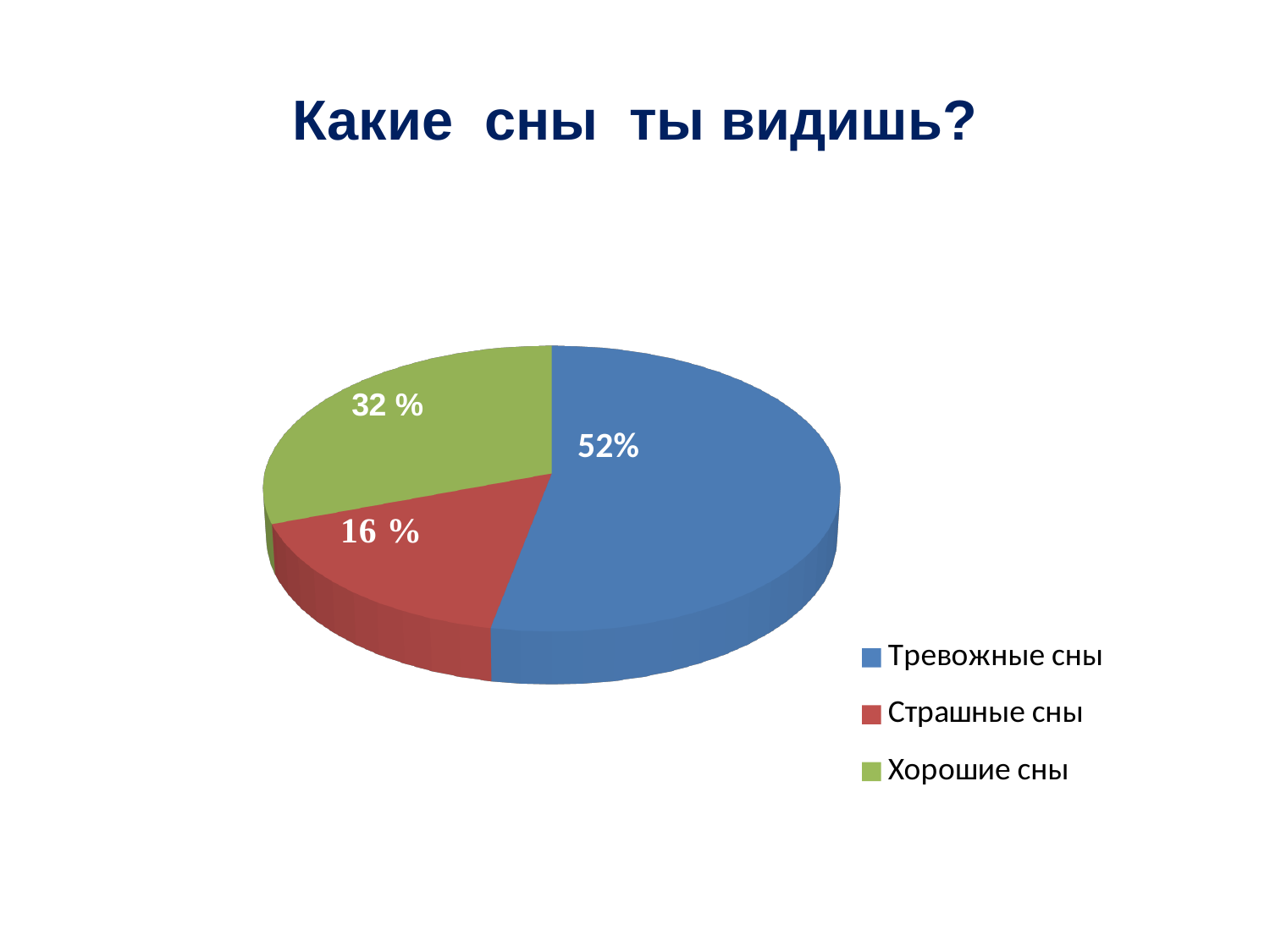
Which category has the smallest slice of the pie? Страшные сны What share of the pie is labelled for Страшные сны? 16 % What share of the pie is labelled for Хорошие сны? 32 % How many categories does the legend list? 3 What colour is the slice for Хорошие сны? green Which category has the largest slice of the pie? Тревожные сны What is the title of the chart? Какие сны ты видишь? What kind of chart is shown on the slide? pie chart What is the difference in percentage points between Тревожные сны and Хорошие сны? 20 How many slices does the pie have? 3 What share of the pie is labelled for Тревожные сны? 52% Which is larger, the slice for Хорошие сны or the slice for Страшные сны? Хорошие сны